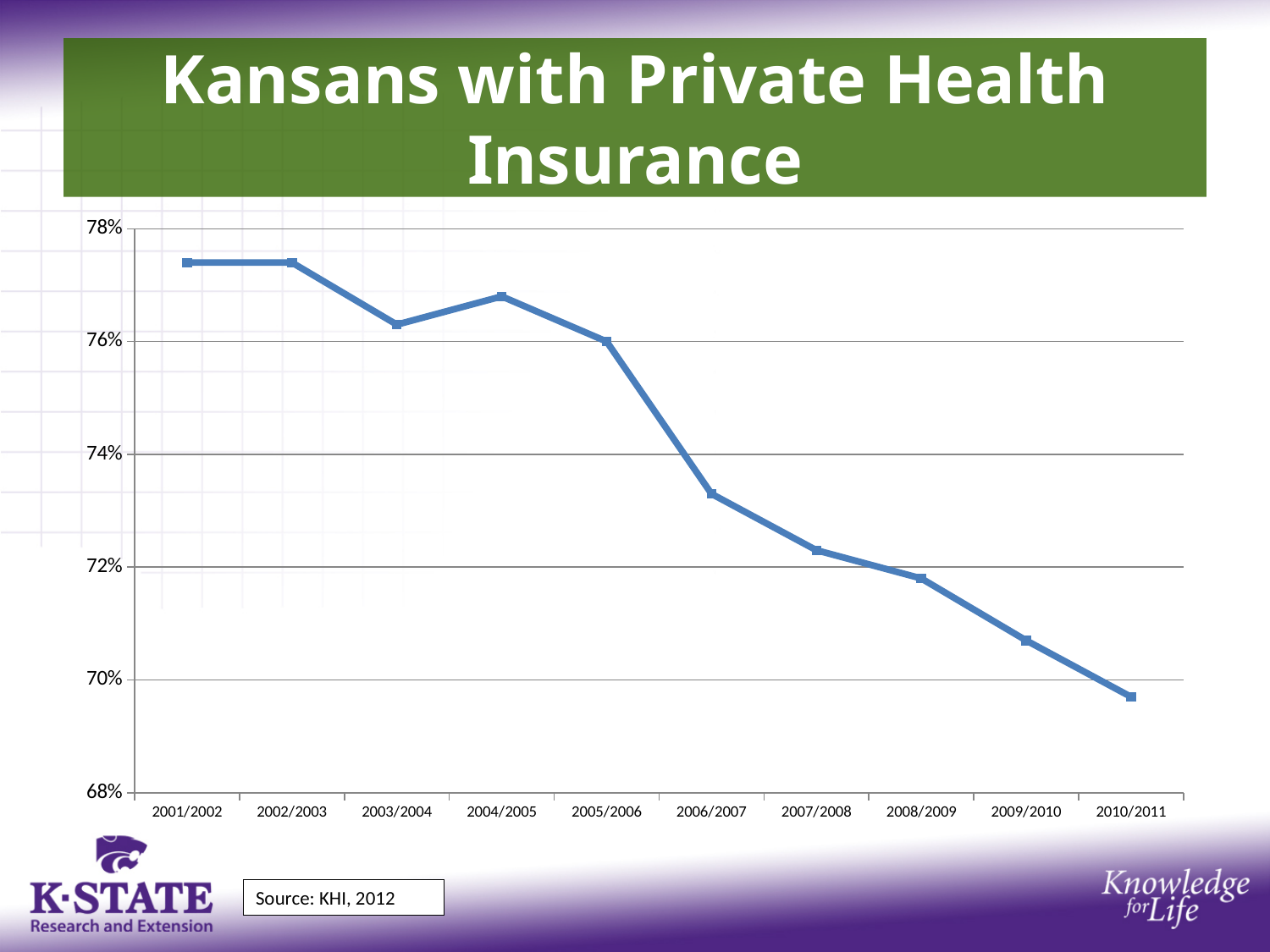
Which period has the lowest value? 2010/2011 Which is larger, the value for 2005/2006 or the value for 2006/2007? 2005/2006 What kind of chart is shown on the slide? line chart Is the value for 2010/2011 greater or less than 70%? less Is the value for 2006/2007 greater or less than 74%? less How many data points are plotted on the line? 10 What is the title of the chart? Kansans with Private Health Insurance Is the value for 2009/2010 greater or less than 70%? greater What source is cited for the chart data? KHI, 2012 Do the values generally rise or fall from 2001/2002 to 2010/2011? fall Which is larger, the value for 2007/2008 or the value for 2010/2011? 2007/2008